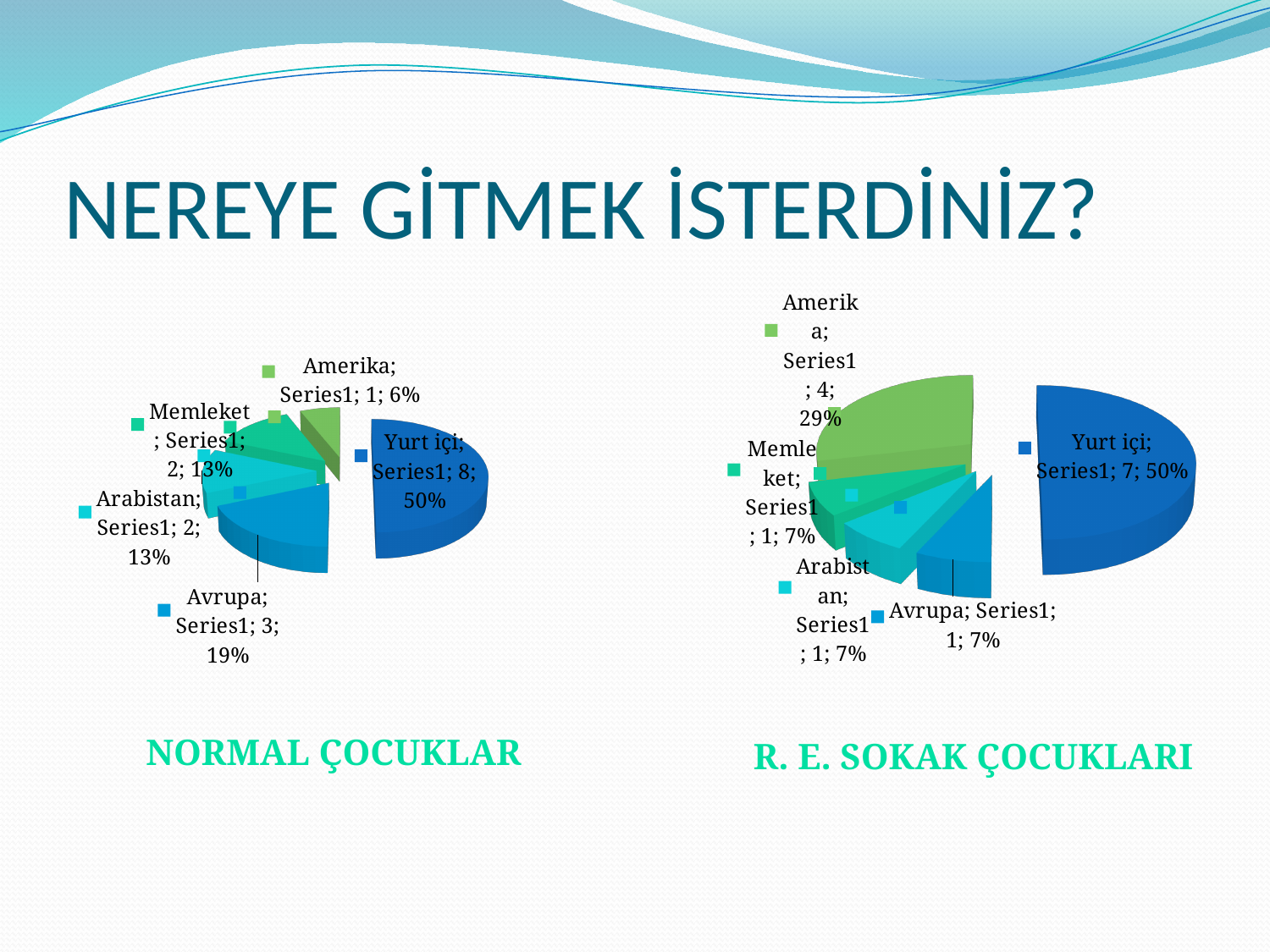
In the R. E. SOKAK ÇOCUKLARI chart, what value is shown for Amerika? 4 In the NORMAL ÇOCUKLAR chart, what percentage share does Avrupa have? 19% In the NORMAL ÇOCUKLAR chart, what value is shown for Yurt içi? 8 In the NORMAL ÇOCUKLAR chart, which category has the smallest slice? Amerika In the NORMAL ÇOCUKLAR chart, what is the difference between the values for Yurt içi and Avrupa? 5 In the R. E. SOKAK ÇOCUKLARI chart, which is larger, the value for Amerika or the value for Avrupa? Amerika What type of chart is used for NORMAL ÇOCUKLAR? Pie chart In the R. E. SOKAK ÇOCUKLARI chart, what is the total of all the slice values? 14 In the R. E. SOKAK ÇOCUKLARI chart, which category has the largest slice? Yurt içi In the NORMAL ÇOCUKLAR chart, how many categories are shown in the pie? 5 In the R. E. SOKAK ÇOCUKLARI chart, what percentage share does Yurt içi have? 50% What is the title of the slide? NEREYE GİTMEK İSTERDİNİZ?